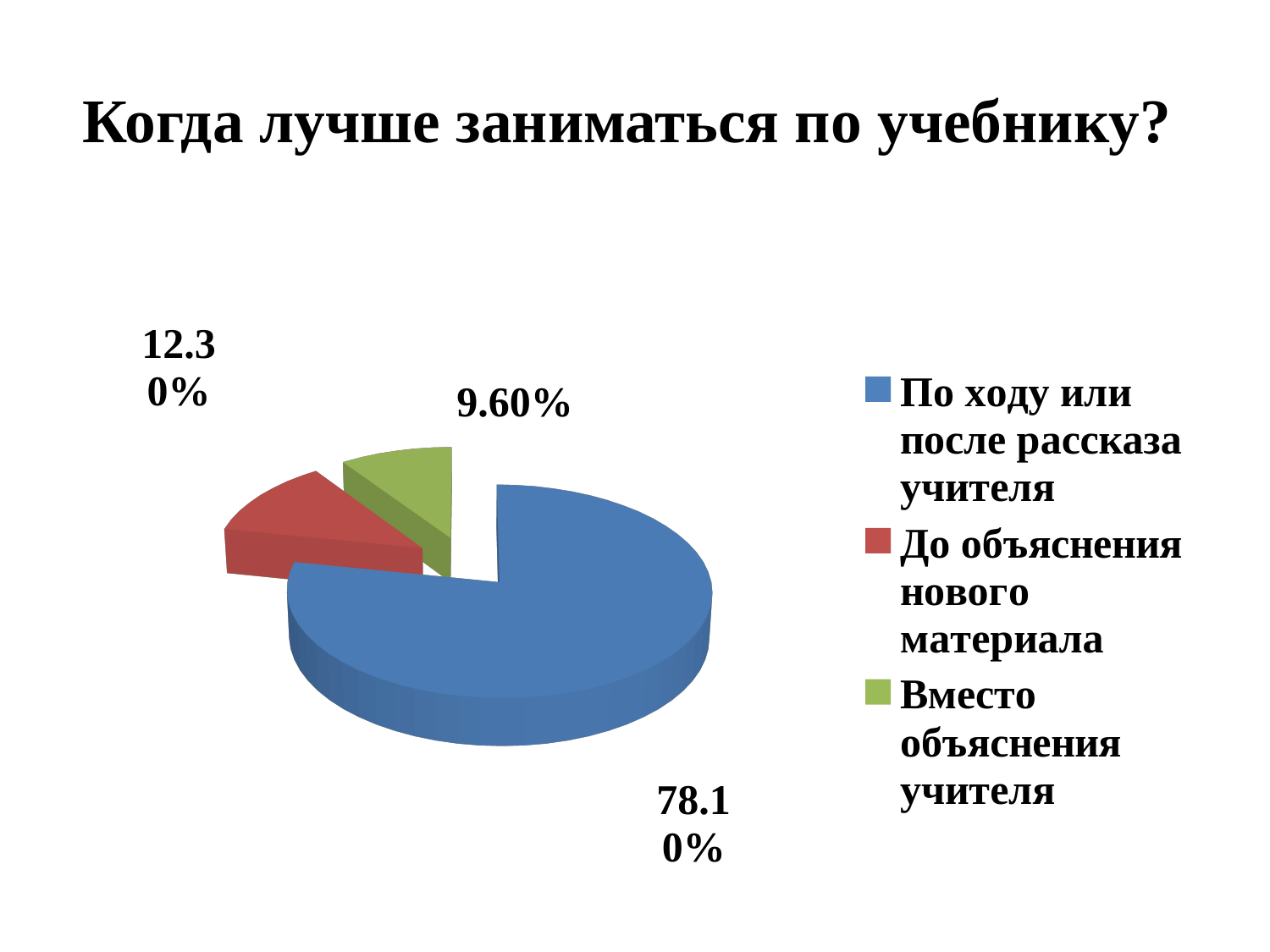
What kind of chart is shown on the slide? Pie chart Which is larger: the slice for 'До объяснения нового материала' or the slice for 'Вместо объяснения учителя'? До объяснения нового материала What is the difference in percentage points between the 'По ходу или после рассказа учителя' slice and the 'До объяснения нового материала' slice? 65.80% What share of the pie is labelled for 'По ходу или после рассказа учителя'? 78.10% What colour is the slice for 'Вместо объяснения учителя'? Green Which category has the smallest slice of the pie? Вместо объяснения учителя What share of the pie is labelled for 'До объяснения нового материала'? 12.30% What is the title of the chart? Когда лучше заниматься по учебнику? Which category has the largest slice of the pie? По ходу или после рассказа учителя How many entries does the legend list? 3 What share of the pie is labelled for 'Вместо объяснения учителя'? 9.60% How many slices does the pie chart have? 3